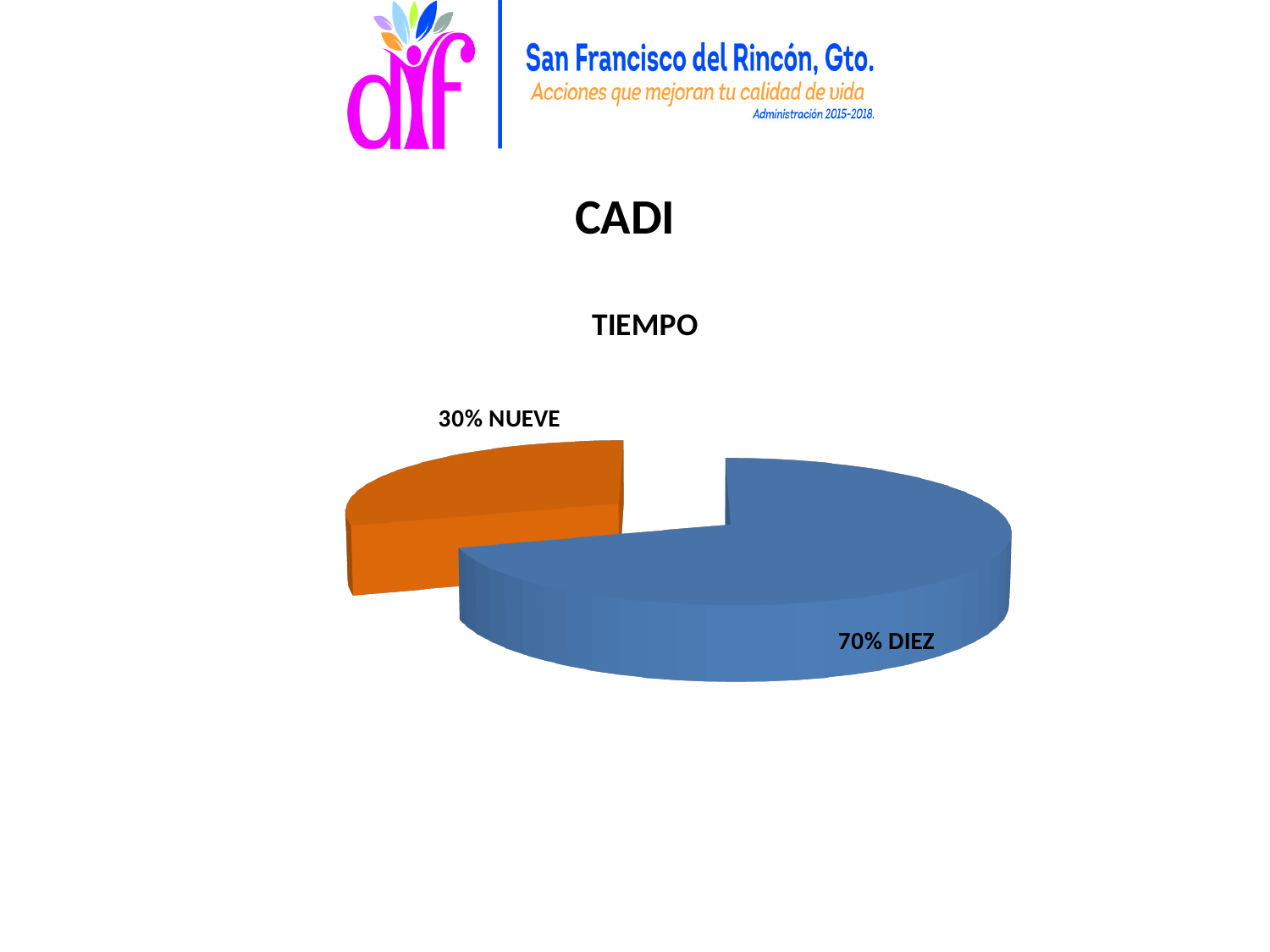
Is the share for NUEVE greater or less than 50%? less What is the title of the chart? TIEMPO What share of the pie does the NUEVE slice represent? 30% Which slice is the smallest in the pie chart? NUEVE Which slice is the largest in the pie chart? DIEZ Which is larger, the DIEZ slice or the NUEVE slice? DIEZ What is the difference in percentage points between the DIEZ and NUEVE slices? 40% What share of the pie does the DIEZ slice represent? 70% What kind of chart is shown on the slide? pie chart How many slices does the pie chart have? 2 What colour is the DIEZ slice? blue